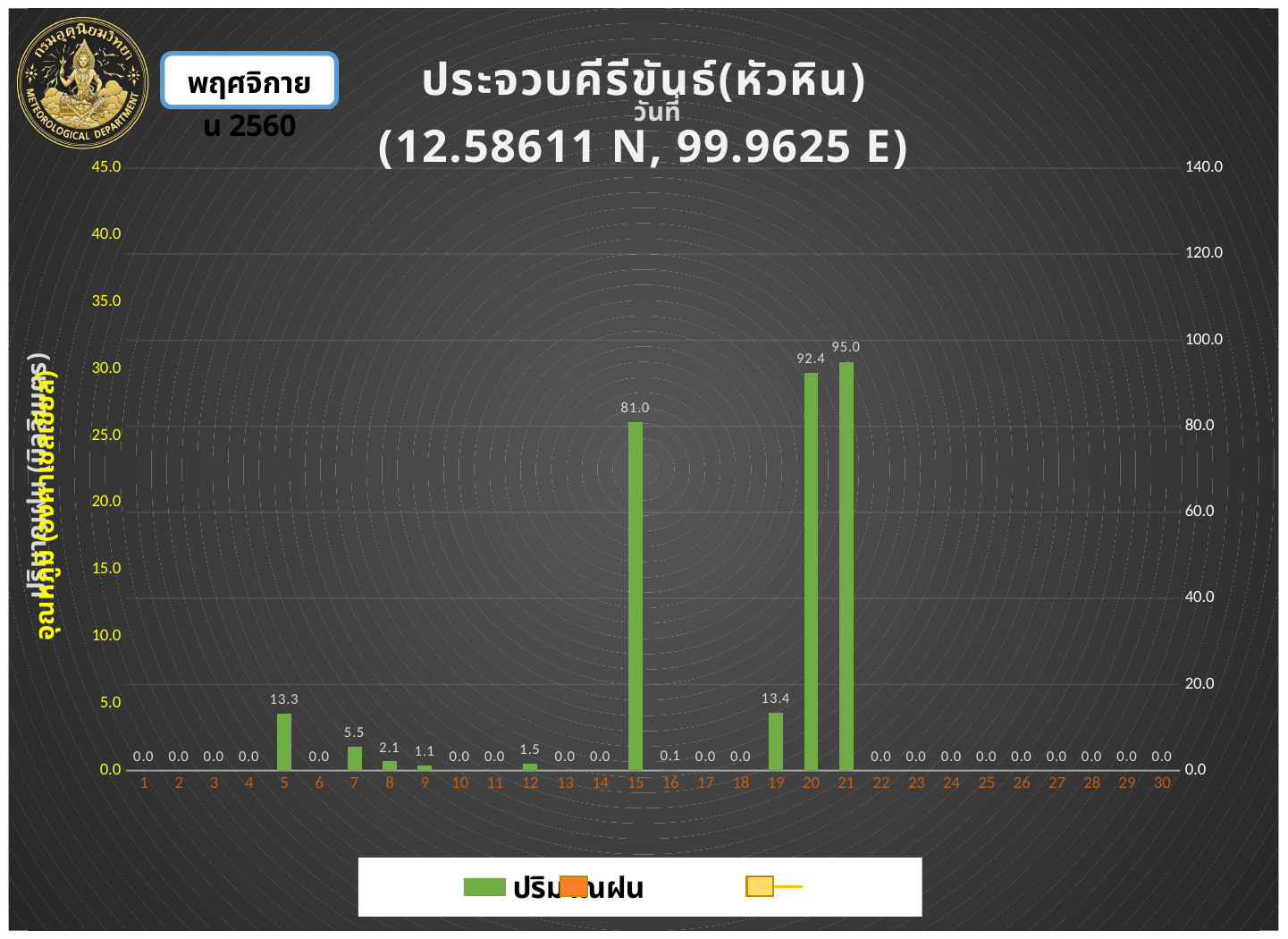
What is the difference between the rainfall values for day 7 and day 8? 3.4 Which is larger, the rainfall value for day 19 or day 5? day 19 What is the rainfall value for day 16? 0.1 What is the difference between the rainfall values for day 21 and day 20? 2.6 What is the rainfall value for day 15? 81.0 What type of chart is shown? bar chart How many days are shown on the x axis? 30 What is the rainfall value for day 5? 13.3 What is the rainfall value for day 12? 1.5 Which day has the highest rainfall value? 21 What is the rainfall value for day 20? 92.4 What are the coordinates given in the chart title? 12.58611 N, 99.9625 E